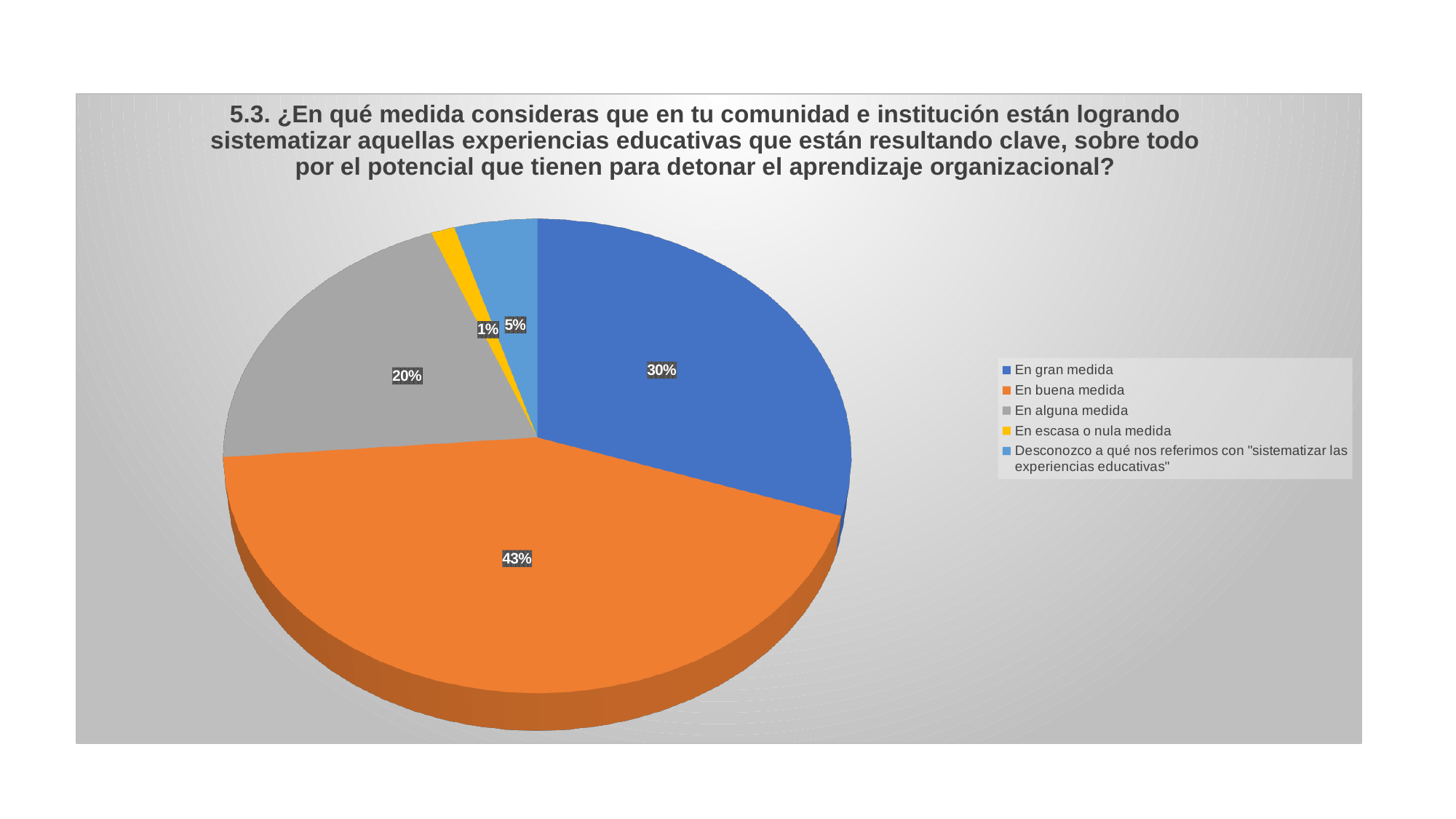
How many categories does the legend list? 5 Which is larger, the share for "En alguna medida" or the share for "Desconozco a qué nos referimos con "sistematizar las experiencias educativas""? En alguna medida What colour is the slice for "En escasa o nula medida"? Yellow What percentage of responses is "En gran medida"? 30% What percentage of responses is "Desconozco a qué nos referimos con "sistematizar las experiencias educativas""? 5% Which category has the smallest share of the pie? En escasa o nula medida Which category has the largest share of the pie? En buena medida What type of chart is shown on the slide? Pie chart What is the difference in percentage points between "En buena medida" and "En gran medida"? 13 What percentage of responses is "En alguna medida"? 20% What percentage of responses is "En escasa o nula medida"? 1% What percentage of responses is "En buena medida"? 43%